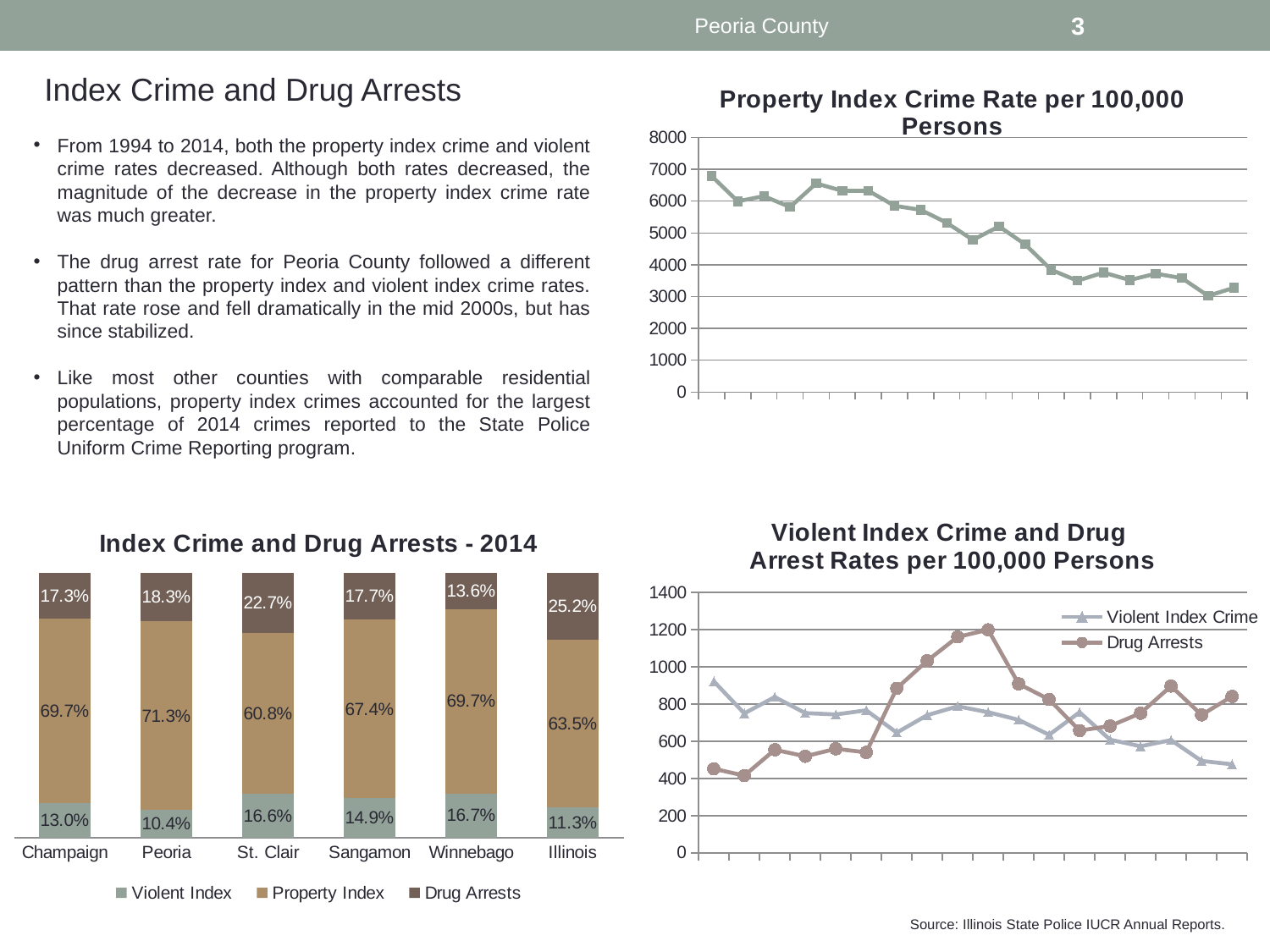
How many series does the legend of the 'Violent Index Crime and Drug Arrest Rates per 100,000 Persons' chart list? 2 In the 'Index Crime and Drug Arrests - 2014' chart, what is the difference between the Drug Arrests values for Illinois and Peoria? 6.9 percentage points What kind of chart is 'Index Crime and Drug Arrests - 2014'? Stacked bar chart In the 'Index Crime and Drug Arrests - 2014' chart, which has the larger Drug Arrests value, St. Clair or Sangamon? St. Clair How many categories are shown on the x axis of the 'Index Crime and Drug Arrests - 2014' chart? 6 In the 'Index Crime and Drug Arrests - 2014' chart, what is the Drug Arrests value for Illinois? 25.2% In the 'Index Crime and Drug Arrests - 2014' chart, which category has the highest Property Index value? Peoria In the 'Index Crime and Drug Arrests - 2014' chart, which category has the lowest Violent Index value? Peoria In the 'Property Index Crime Rate per 100,000 Persons' chart, do the values generally rise or fall along the x axis? Fall In the 'Property Index Crime Rate per 100,000 Persons' chart, is the last plotted value greater or less than 4000? less How many series does the legend of the 'Index Crime and Drug Arrests - 2014' chart list? 3 In the 'Index Crime and Drug Arrests - 2014' chart, what is the Property Index value for Peoria? 71.3%